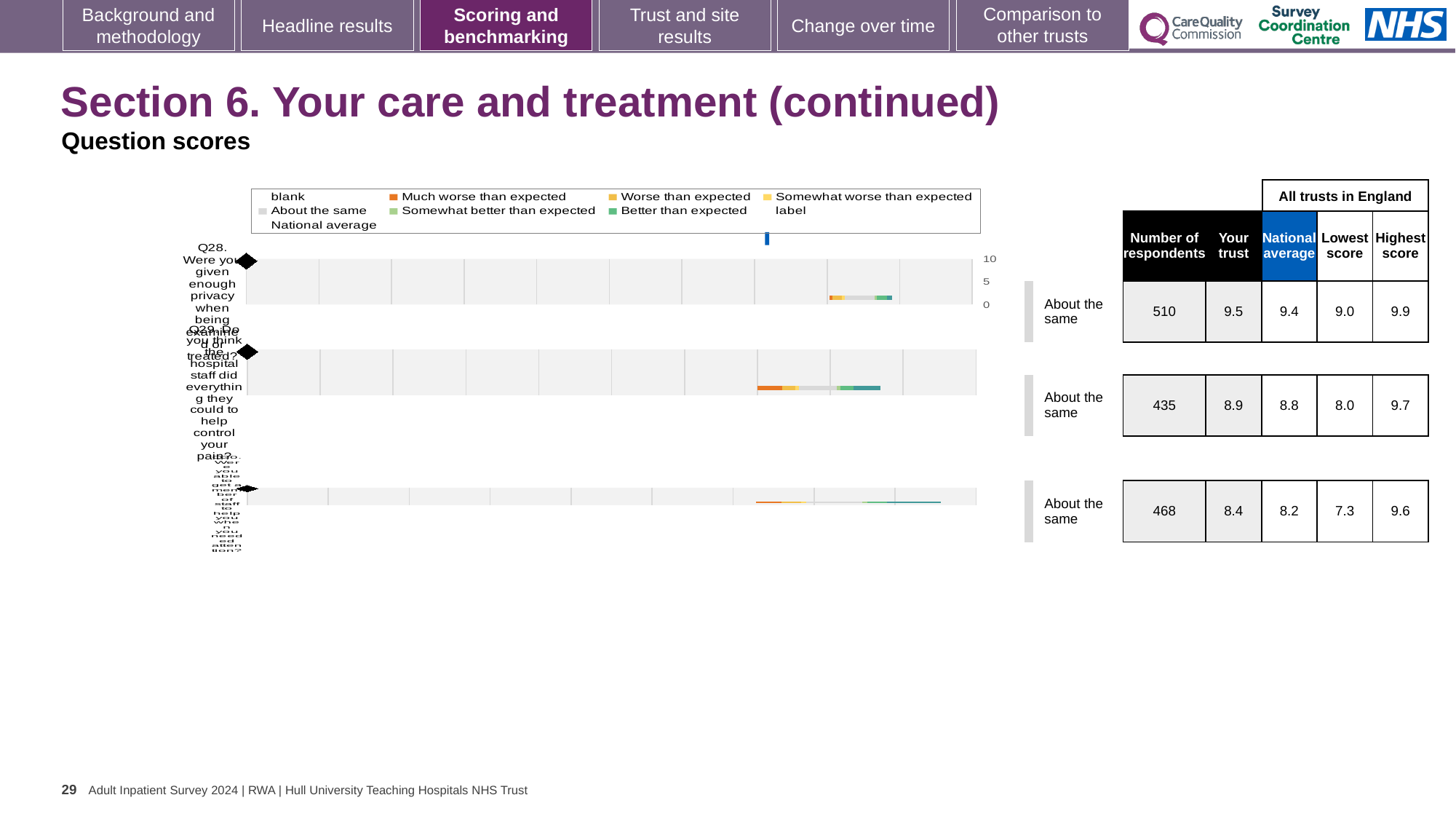
How many respondents answered the third question (Q30) in the chart? 468 How many entries does the chart legend list? 9 Which question has the highest 'Your trust' score? Q28 How many survey questions are plotted in the chart? 3 What is the national average score for Q29 (Do you think the hospital staff did everything they could to help control your pain?)? 8.8 Which question has the lowest 'Your trust' score? Q30 For Q29, which is larger: the 'Your trust' score or the national average? Your trust (8.9) What kind of chart is shown on the slide? bar chart What is the 'Your trust' score for Q28 (Were you given enough privacy when being examined or treated?)? 9.5 What benchmark category is shown next to the chart for Q29? About the same What is the difference between the 'Your trust' score and the national average for Q28? 0.1 Is the trust's plotted score for Q28 greater or less than 5 on the chart axis? greater